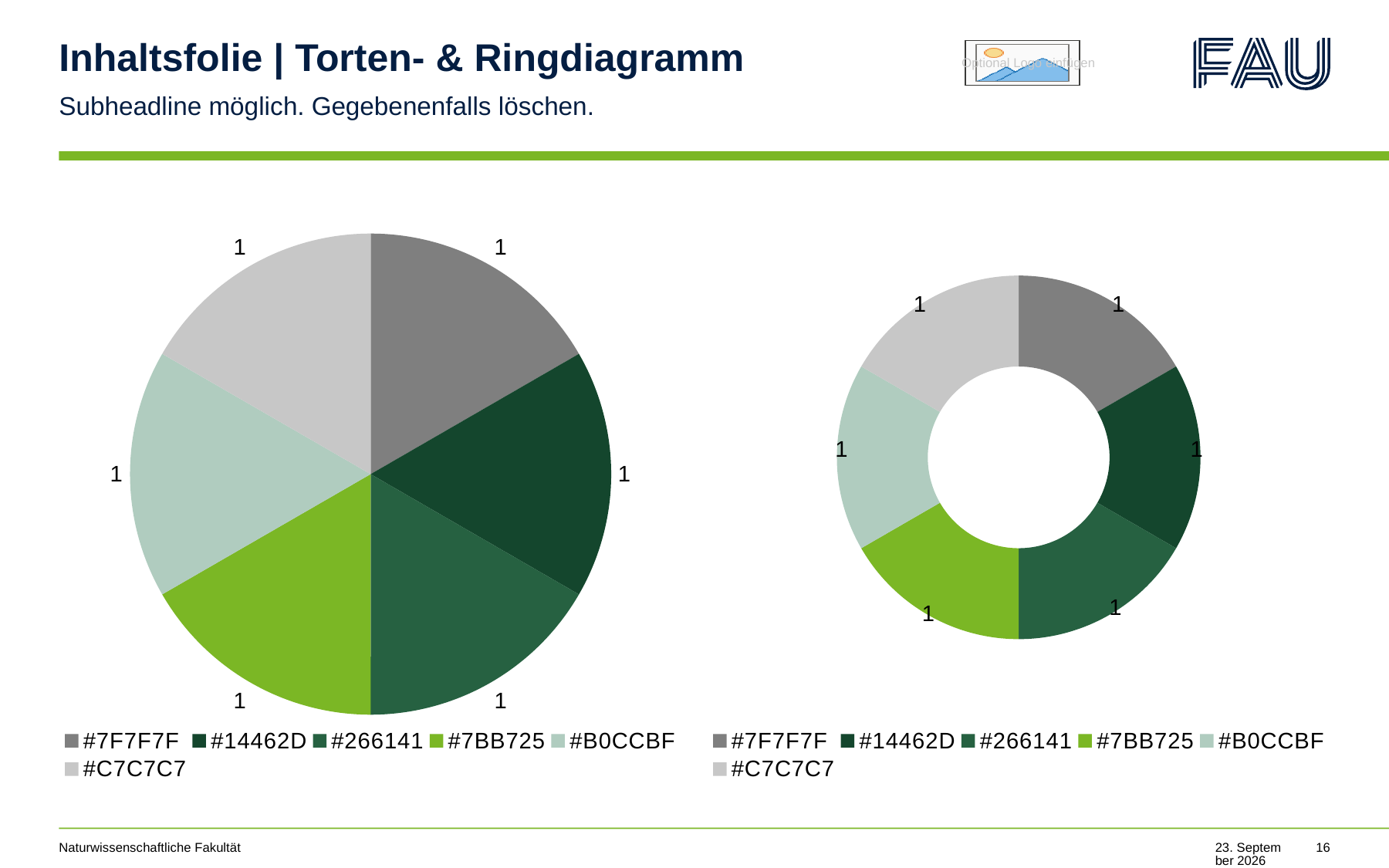
In the pie chart on the left, what share of the whole does the #14462D slice represent? 1/6 In the pie chart on the left, what is the value of the #7BB725 slice? 1 How many slices does the pie chart on the left have? 6 How many segments does the doughnut chart on the right have? 6 In the pie chart on the left, what is the value of the #C7C7C7 slice? 1 In the doughnut chart on the right, what is the difference between the #B0CCBF value and the #7F7F7F value? 0 What is the total of all slice values in the pie chart on the left? 6 What kind of chart is the chart on the right side of the slide? Doughnut (ring) chart In the pie chart on the left, which is larger, the #7F7F7F slice or the #266141 slice? They are equal What is the first entry listed in the legend of the doughnut chart on the right? #7F7F7F In the doughnut chart on the right, what is the value of the #14462D segment? 1 What kind of chart is the chart on the left side of the slide? Pie chart